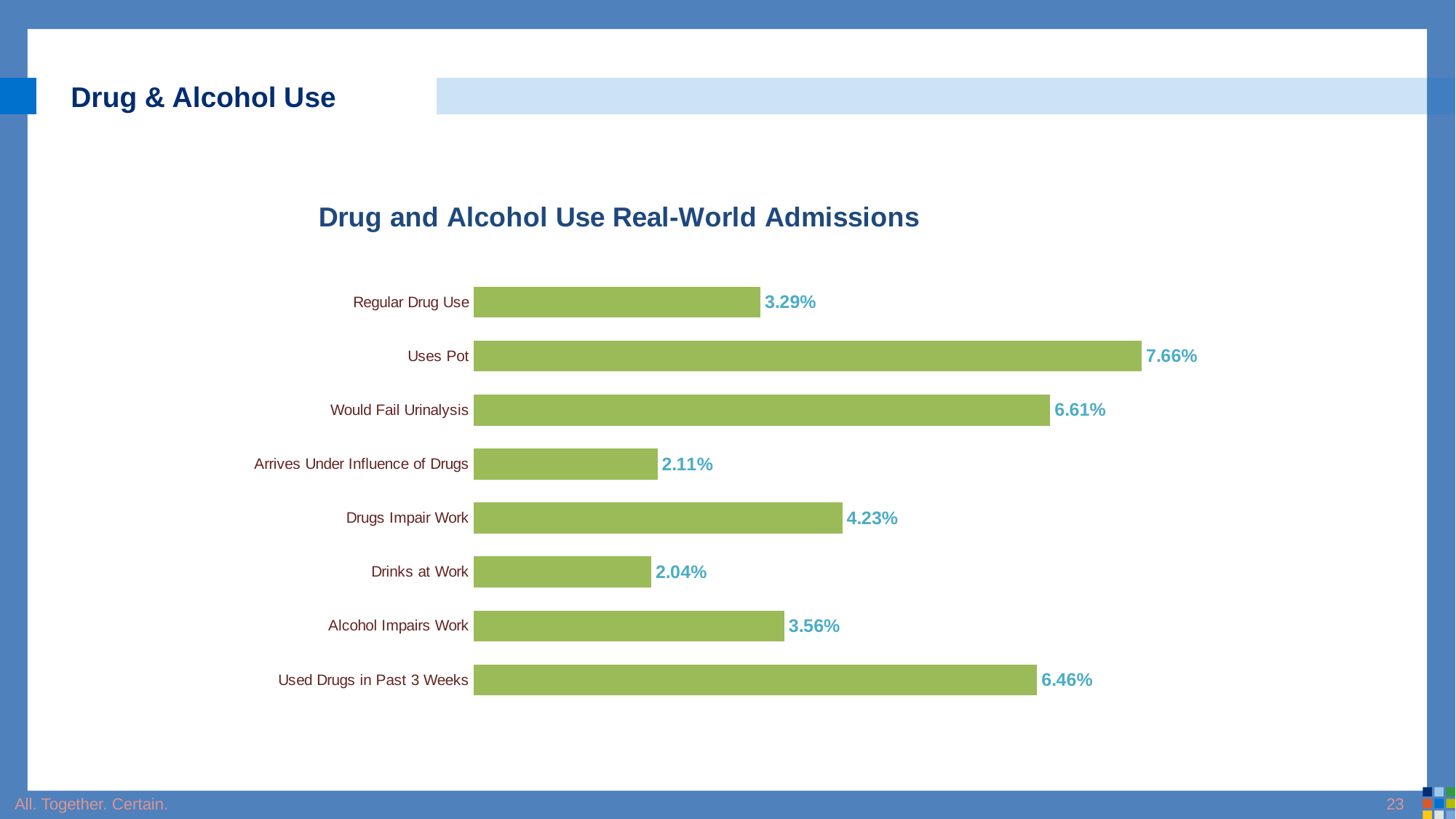
What is the difference between the values for Uses Pot and Regular Drug Use? 4.37% What kind of chart is shown on the slide? Bar chart Which category has the lowest value? Drinks at Work What is the difference between the values for Drugs Impair Work and Alcohol Impairs Work? 0.67% What is the value for Uses Pot? 7.66% What is the value for Drinks at Work? 2.04% Which is larger, the value for Would Fail Urinalysis or the value for Used Drugs in Past 3 Weeks? Would Fail Urinalysis What is the title of the chart? Drug and Alcohol Use Real-World Admissions What is the value for Used Drugs in Past 3 Weeks? 6.46% Which category has the highest value? Uses Pot What is the value for Would Fail Urinalysis? 6.61% How many categories are shown in the chart? 8